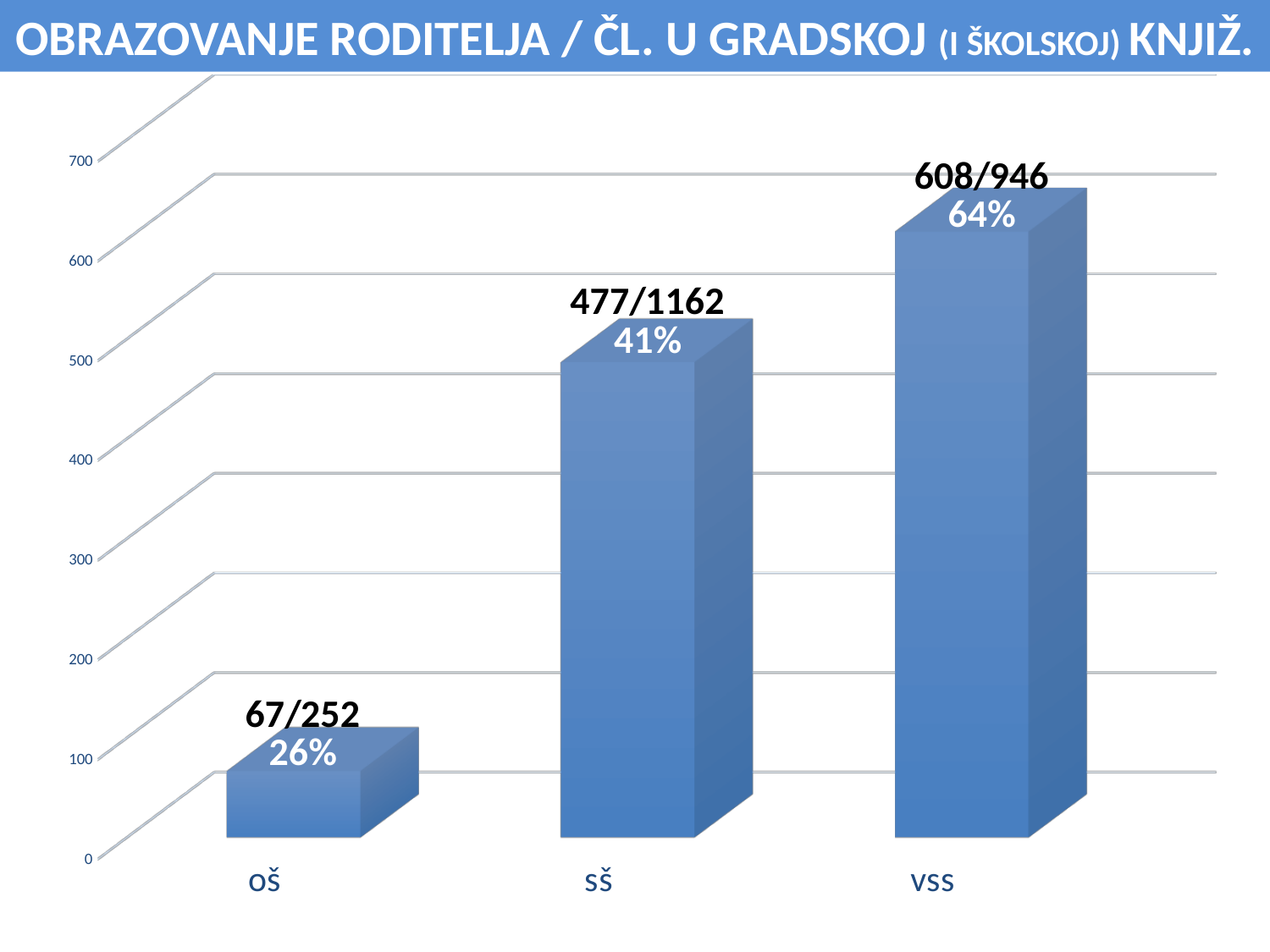
What fraction label is printed above the VSS bar? 608/946 What fraction label is printed above the OŠ bar? 67/252 Which category has the highest bar? VSS Is the value for VSS greater or less than 500? greater What percentage is shown for the SŠ category? 41% How many categories are shown on the x axis? 3 What is the difference in percentage points between VSS (64%) and OŠ (26%)? 38 Which category has the lowest bar? OŠ What kind of chart is shown on the slide? bar chart What percentage is shown for the OŠ category? 26% What percentage is shown for the VSS category? 64% Which is larger, the bar for SŠ or the bar for OŠ? SŠ